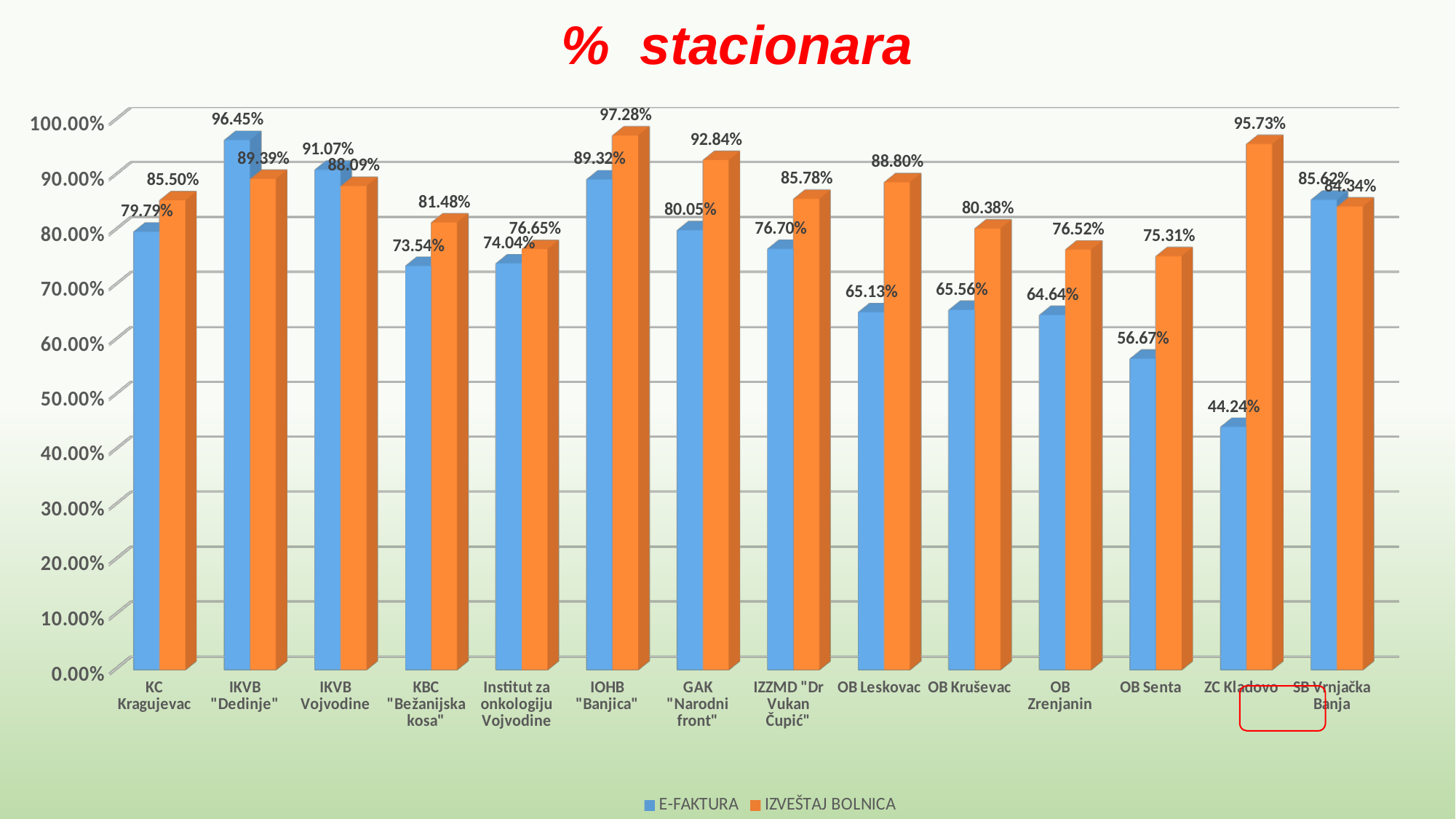
Is the E-FAKTURA value for OB Senta greater or less than 60.00%? less What is the E-FAKTURA value for ZC Kladovo? 44.24% What is the difference between the IZVEŠTAJ BOLNICA and E-FAKTURA values for ZC Kladovo? 51.49 percentage points For IKVB "Dedinje", which is larger: the E-FAKTURA value or the IZVEŠTAJ BOLNICA value? E-FAKTURA Which category has the lowest E-FAKTURA value? ZC Kladovo Which category has the lowest IZVEŠTAJ BOLNICA value? OB Senta What kind of chart is shown on the slide? Bar chart What is the IZVEŠTAJ BOLNICA value for IOHB "Banjica"? 97.28% How many series does the legend list? 2 How many categories are shown on the x axis? 14 Which category has the highest E-FAKTURA value? IKVB "Dedinje" What is the E-FAKTURA value for OB Leskovac? 65.13%